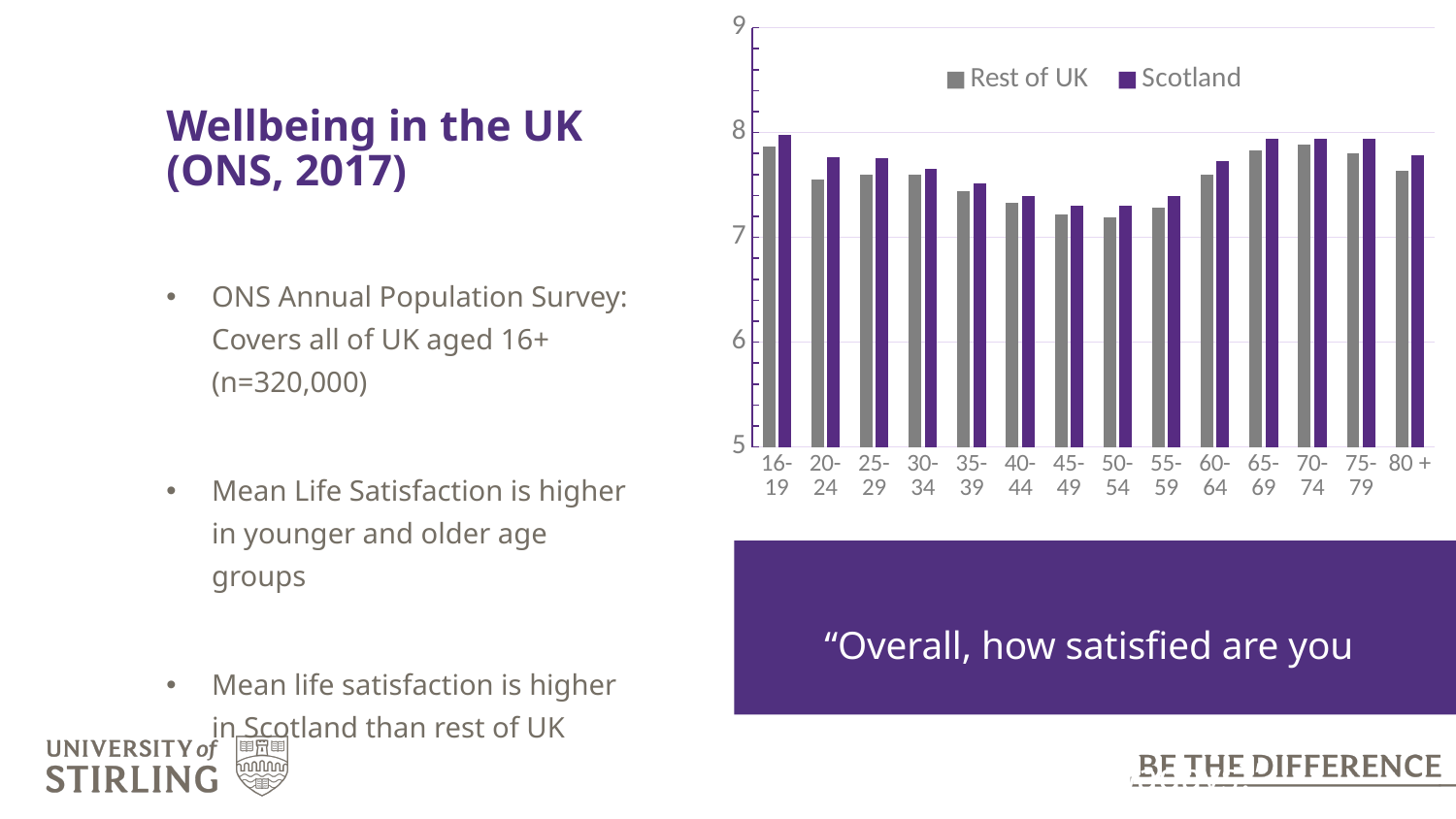
How many series does the chart's legend list? 2 For the 20-24 age group, which series has the higher bar, Rest of UK or Scotland? Scotland What kind of chart is shown on the slide? Bar chart Which two series are listed in the chart's legend? Rest of UK and Scotland Do the Scotland values rise or fall from the 50-54 age group to the 75-79 age group? rise Is the Rest of UK value for the 16-19 age group greater or less than 8? less Is the Scotland value for the 45-49 age group greater or less than 7? greater How many age-group categories are shown on the x axis of the chart? 14 What colour are the Scotland bars in the chart? Purple For the 16-19 age group, which series has the higher bar, Rest of UK or Scotland? Scotland For the 60-64 age group, which series has the higher bar, Rest of UK or Scotland? Scotland Do the Rest of UK values rise or fall from the 16-19 age group to the 50-54 age group? fall